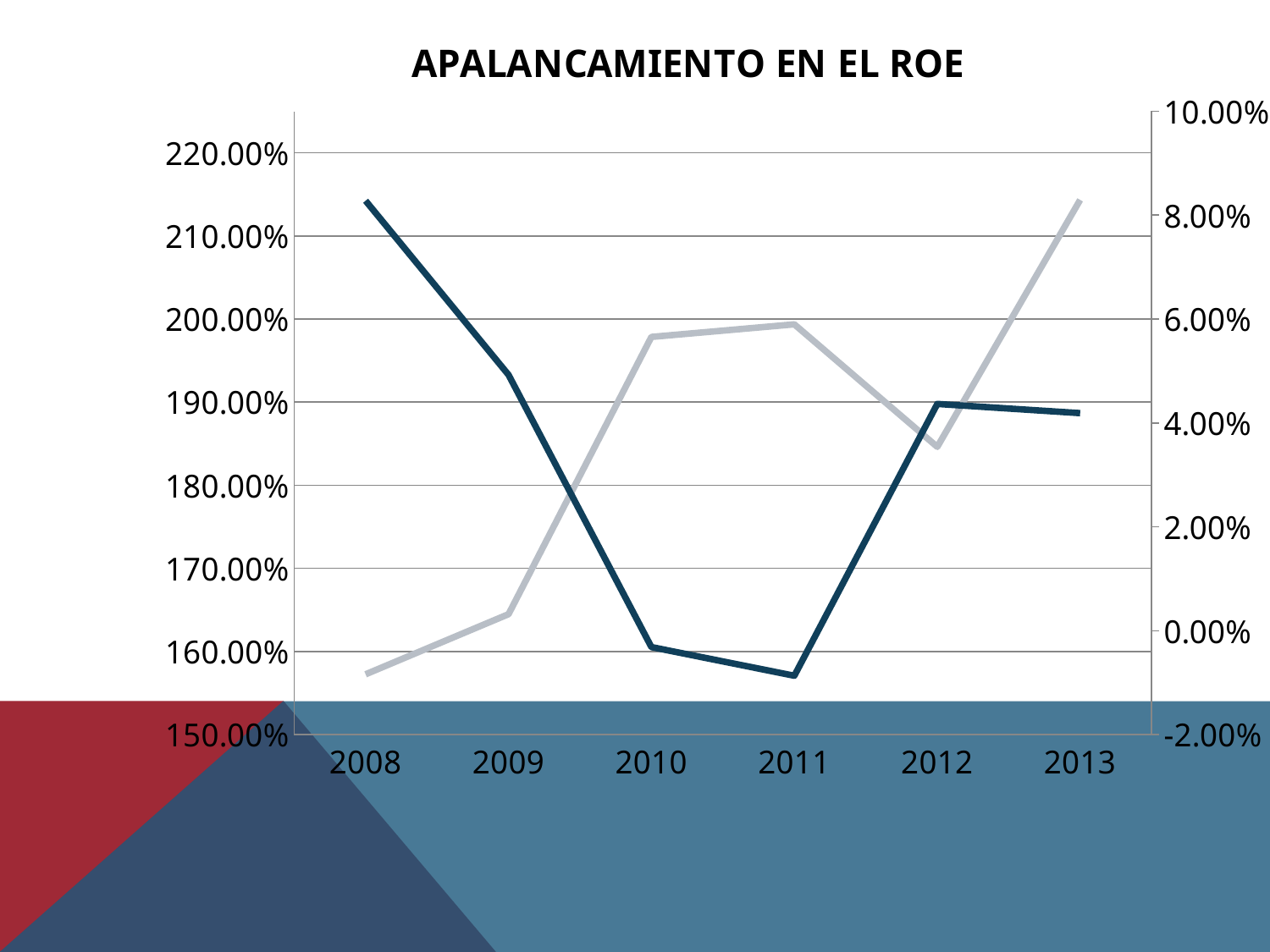
What kind of chart is shown on the slide? line chart Does the dark blue line rise or fall from 2008 to 2011? fall In which year does the light gray line reach its highest point? 2013 Does the light gray line rise or fall from 2008 to 2010? rise How many years are shown on the x axis of the chart? 6 In which year does the light gray line reach its lowest point? 2008 Is the light gray line higher in 2010 or in 2012? 2010 In which year does the dark blue line reach its lowest point? 2011 What is the highest value labelled on the right-hand axis? 10.00% In which year does the dark blue line reach its highest point? 2008 What is the title of the chart? APALANCAMIENTO EN EL ROE How many lines are plotted on the chart? 2